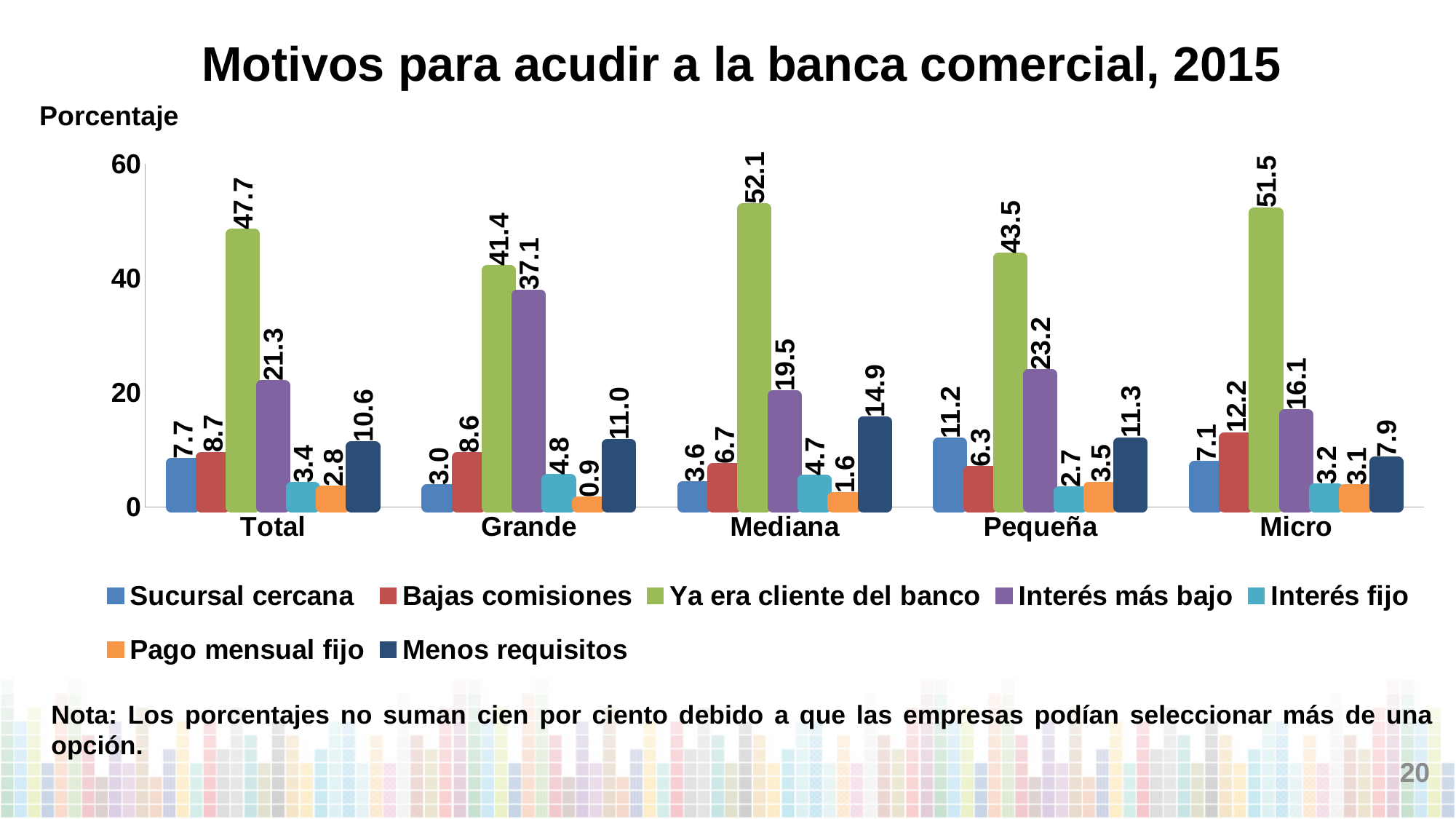
What kind of chart is shown on the slide? Bar chart What is the value for "Interés más bajo" in the Grande category? 37.1 What is the title of the chart? Motivos para acudir a la banca comercial, 2015 Which category has the lowest value for "Pago mensual fijo"? Grande Which category has the highest value for "Ya era cliente del banco"? Mediana Which is larger: "Bajas comisiones" for Micro or "Bajas comisiones" for Total? Micro What is the value for "Menos requisitos" in the Micro category? 7.9 How many series does the legend list? 7 How many categories are shown on the x axis? 5 What is the difference between the "Ya era cliente del banco" value and the "Interés más bajo" value in the Total category? 26.4 What is the value for "Sucursal cercana" in the Pequeña category? 11.2 What is the value for "Ya era cliente del banco" in the Mediana category? 52.1